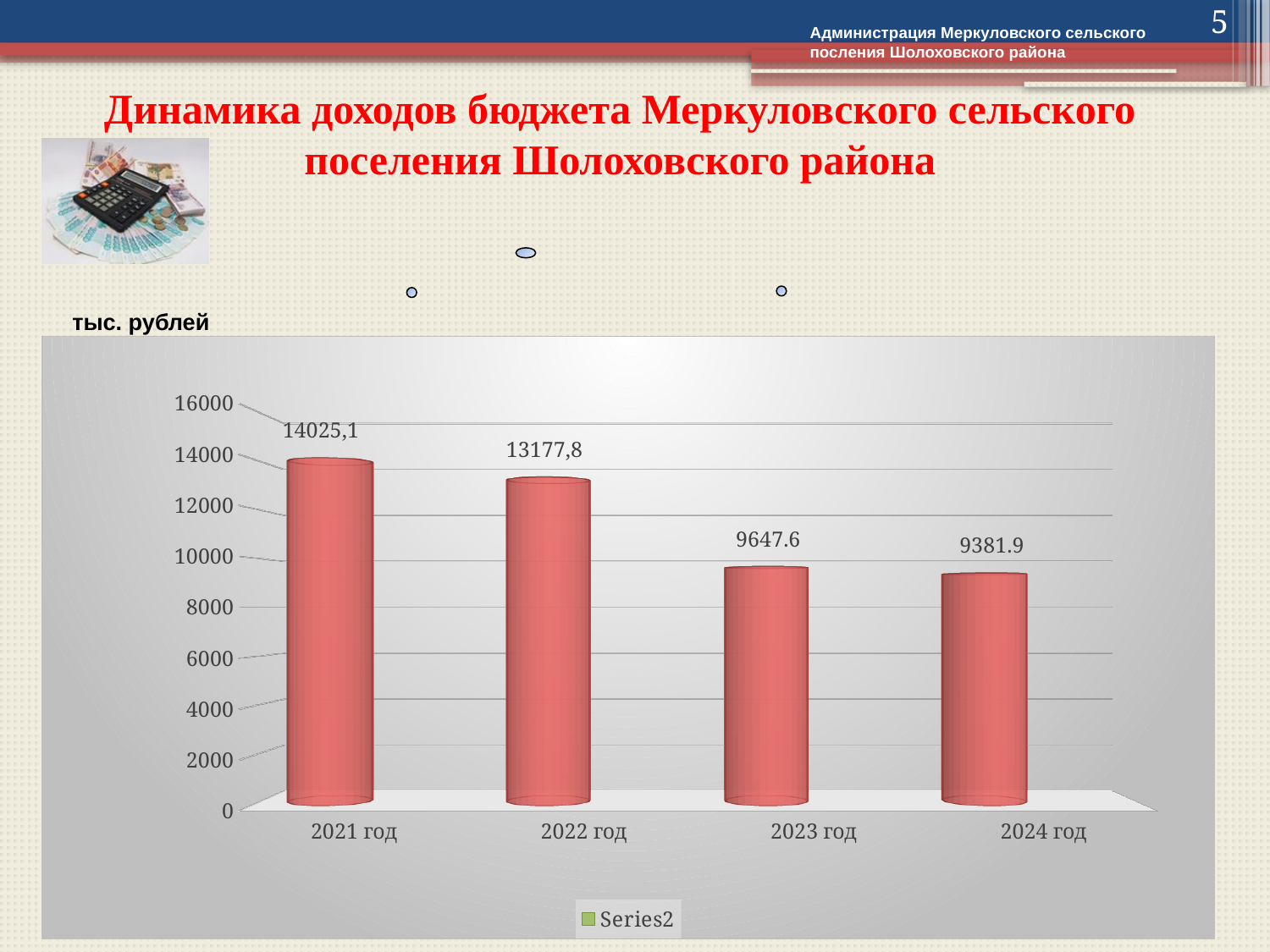
Which year has the lowest value? 2024 год What kind of chart is shown on the slide? bar chart What is the difference between the values for 2021 год and 2022 год? 847,3 Do the values rise or fall from 2021 год to 2024 год? fall Which year has the highest value? 2021 год Is the value for 2022 год greater or less than 12000? greater What is the value for 2021 год? 14025,1 What is the difference between the values for 2023 год and 2024 год? 265.7 What is the value for 2024 год? 9381.9 Which is larger, the value for 2022 год or the value for 2023 год? 2022 год What is the value for 2023 год? 9647.6 How many years are shown on the x axis? 4